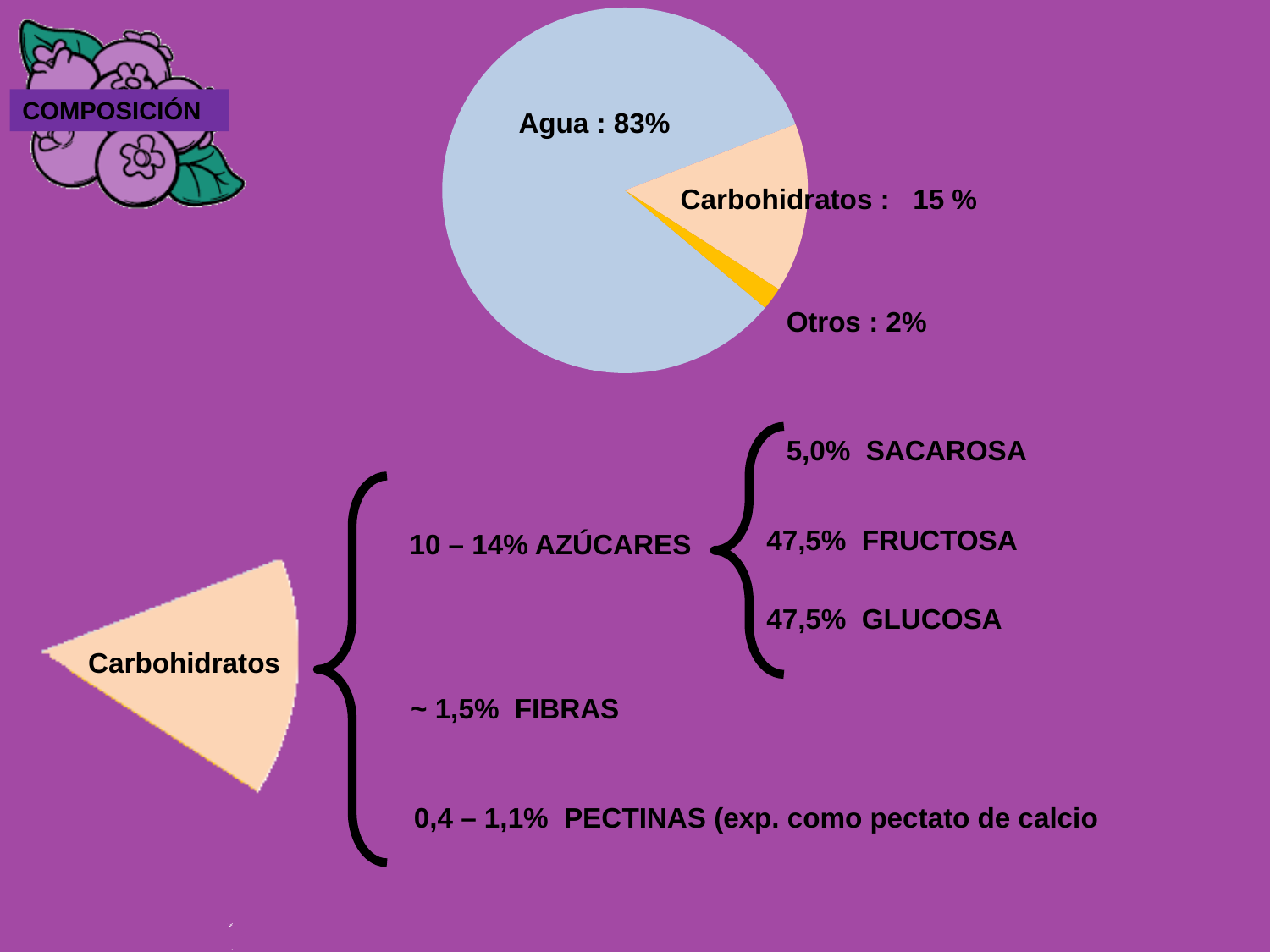
Which slice of the pie chart is the smallest? Otros What share of the pie does the Otros slice represent? 2% What percentage does the pie chart show for Carbohidratos? 15 % What colour is the Agua slice in the pie chart? Light blue What percentage does the pie chart show for Agua? 83% What percentage does the pie chart show for Otros? 2% What kind of chart is shown at the top of the slide? Pie chart Which slice of the pie chart is the largest? Agua How many slices does the pie chart have? 3 What is the difference in percentage points between Agua and Carbohidratos in the pie chart? 68% In the pie chart, which is larger: Carbohidratos or Otros? Carbohidratos What is the difference in percentage points between Carbohidratos and Otros in the pie chart? 13%